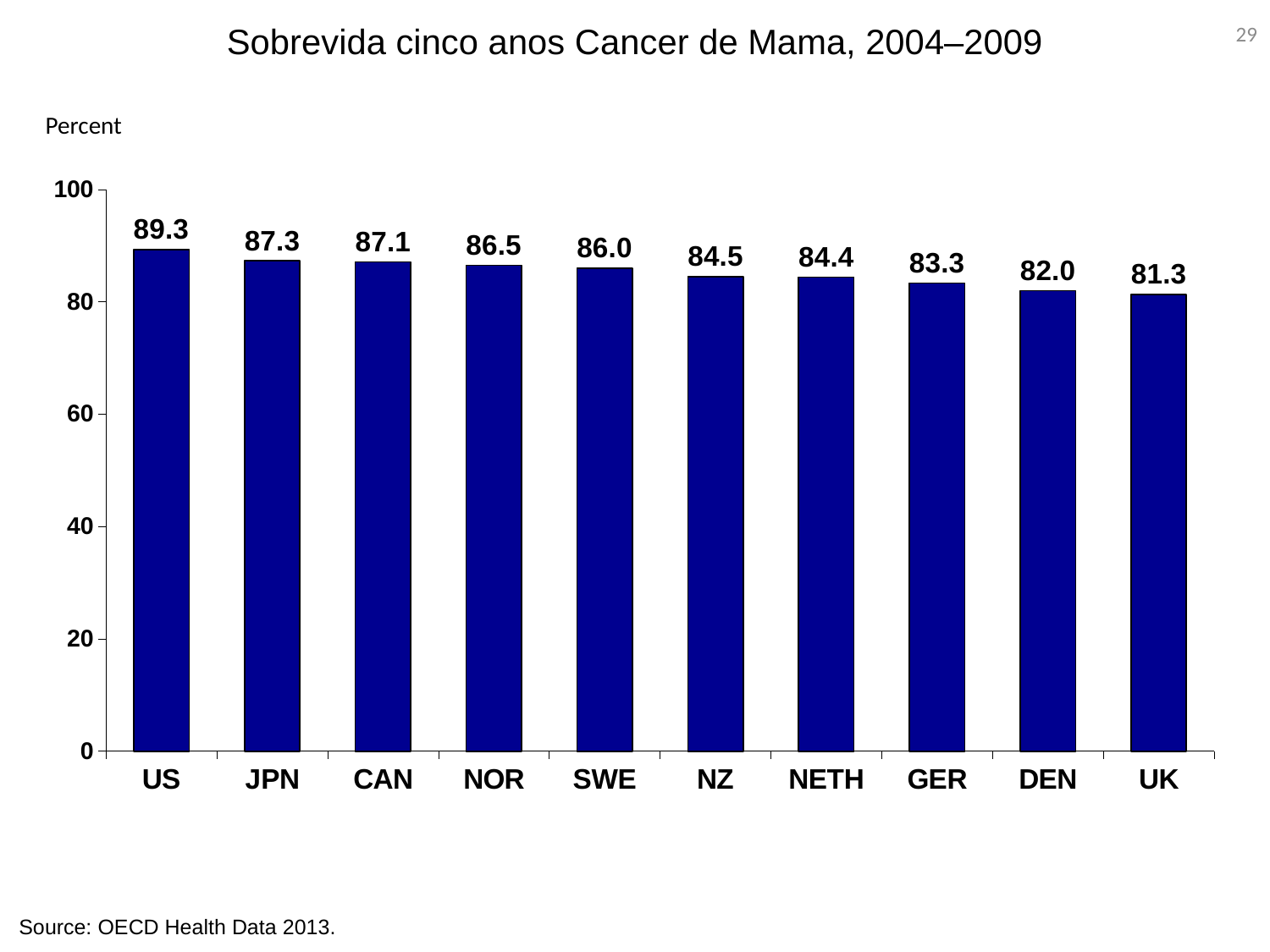
Which country has the lowest value? UK What is the five-year breast cancer survival value for the US? 89.3 What is the value shown for DEN? 82.0 What is the source cited for the chart data? OECD Health Data 2013 What is the difference between the values for US and UK? 8.0 Which country has the highest value? US What kind of chart is shown on the slide? bar chart How many countries are shown on the chart? 10 What is the difference between the values for JPN and GER? 4.0 What is the value shown for NETH? 84.4 Which has a larger value, NOR or NZ? NOR Is the value for SWE greater or less than 80? greater